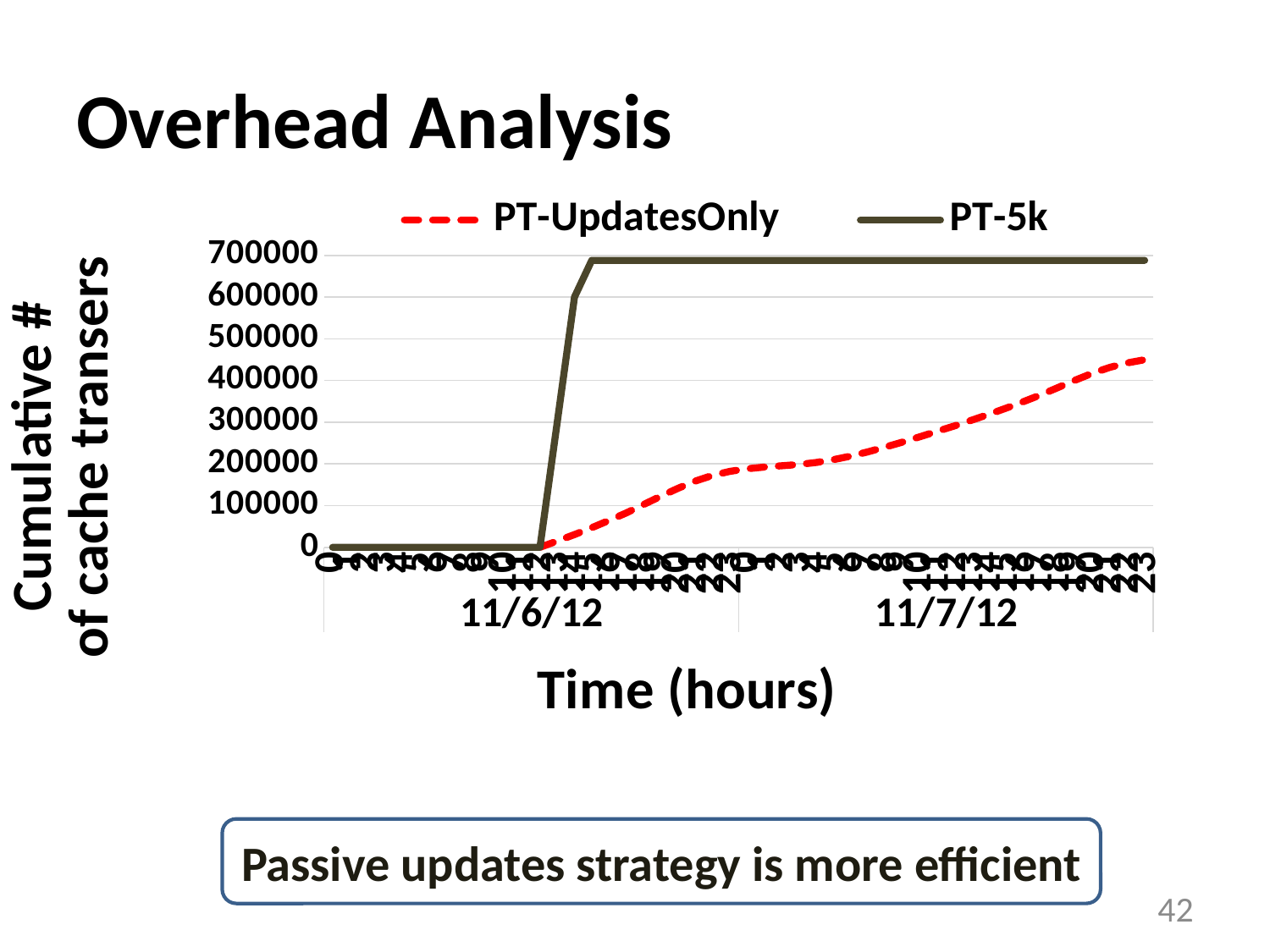
Which series has the lower cumulative value at the right end of the chart? PT-UpdatesOnly Is the final value for PT-UpdatesOnly greater or less than 500000? less Is the final value for PT-5k greater or less than 600000? greater Which series reaches the higher cumulative number of cache transfers by the end of the chart? PT-5k What are the two series named in the legend? PT-UpdatesOnly and PT-5k What kind of chart is shown on the slide? line chart How many dates are labelled on the x axis? 2 Which series is drawn as a red dashed line? PT-UpdatesOnly How many series does the legend list? 2 Is the final value for PT-UpdatesOnly greater or less than 400000? greater Does the PT-UpdatesOnly line rise or fall along the x axis after 11/6/12? rise What is the highest value labelled on the y axis? 700000